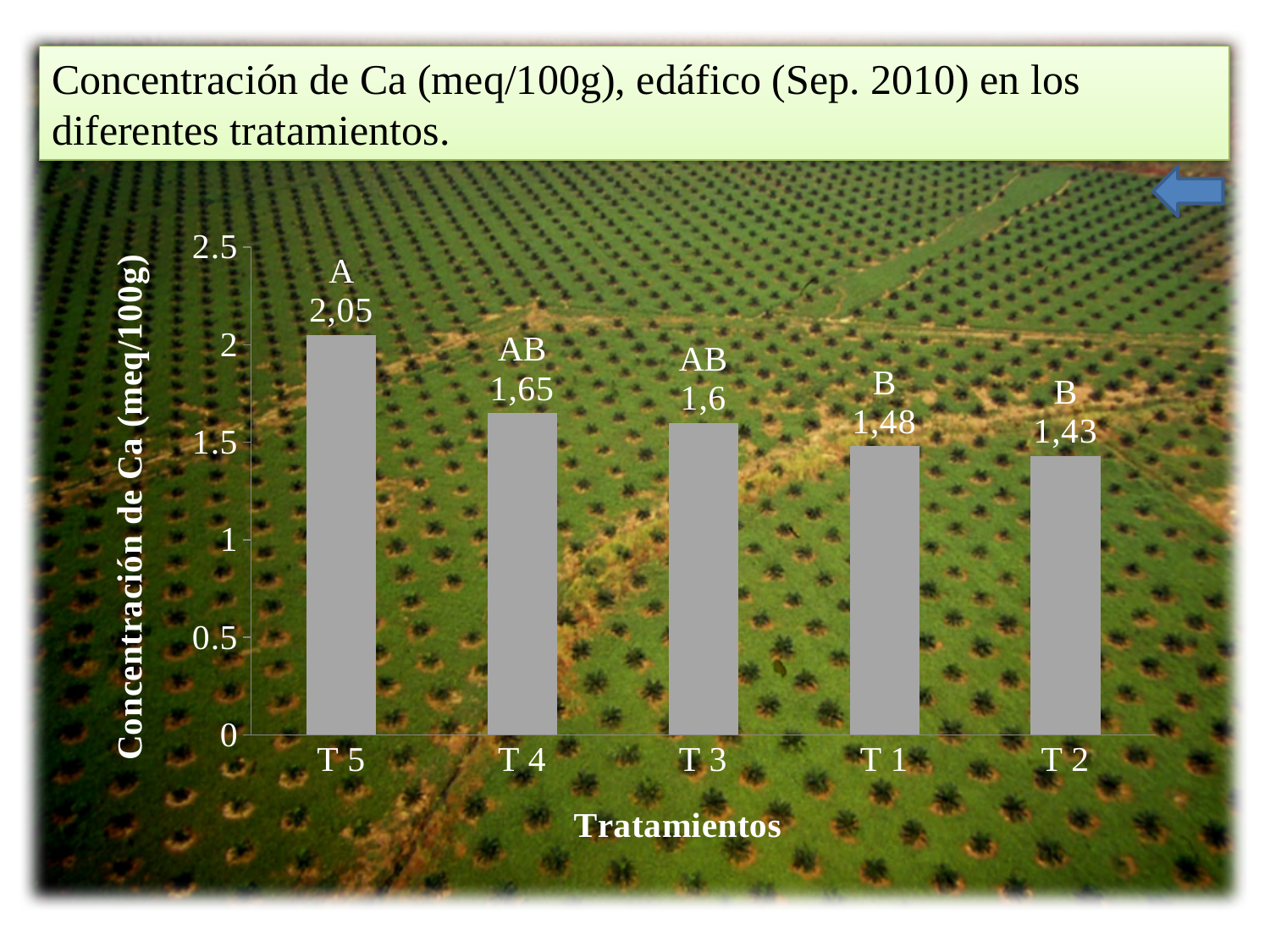
Which treatment has the lowest Ca concentration? T 2 What statistical group letter is printed above the bar for T 4? AB Which treatment has the highest Ca concentration? T 5 Which has a larger Ca concentration, T 4 or T 1? T 4 What is the Ca concentration value shown for treatment T 3? 1,6 What is the Ca concentration value shown for treatment T 2? 1,43 What kind of chart is shown on the slide? Bar chart How many treatments are shown on the x axis? 5 What is the difference between the Ca concentration values for T 5 and T 2? 0,62 What is the difference between the Ca concentration values for T 5 and T 4? 0,4 What is the Ca concentration value shown for treatment T 5? 2,05 Is the value for T 5 greater or less than 2? greater